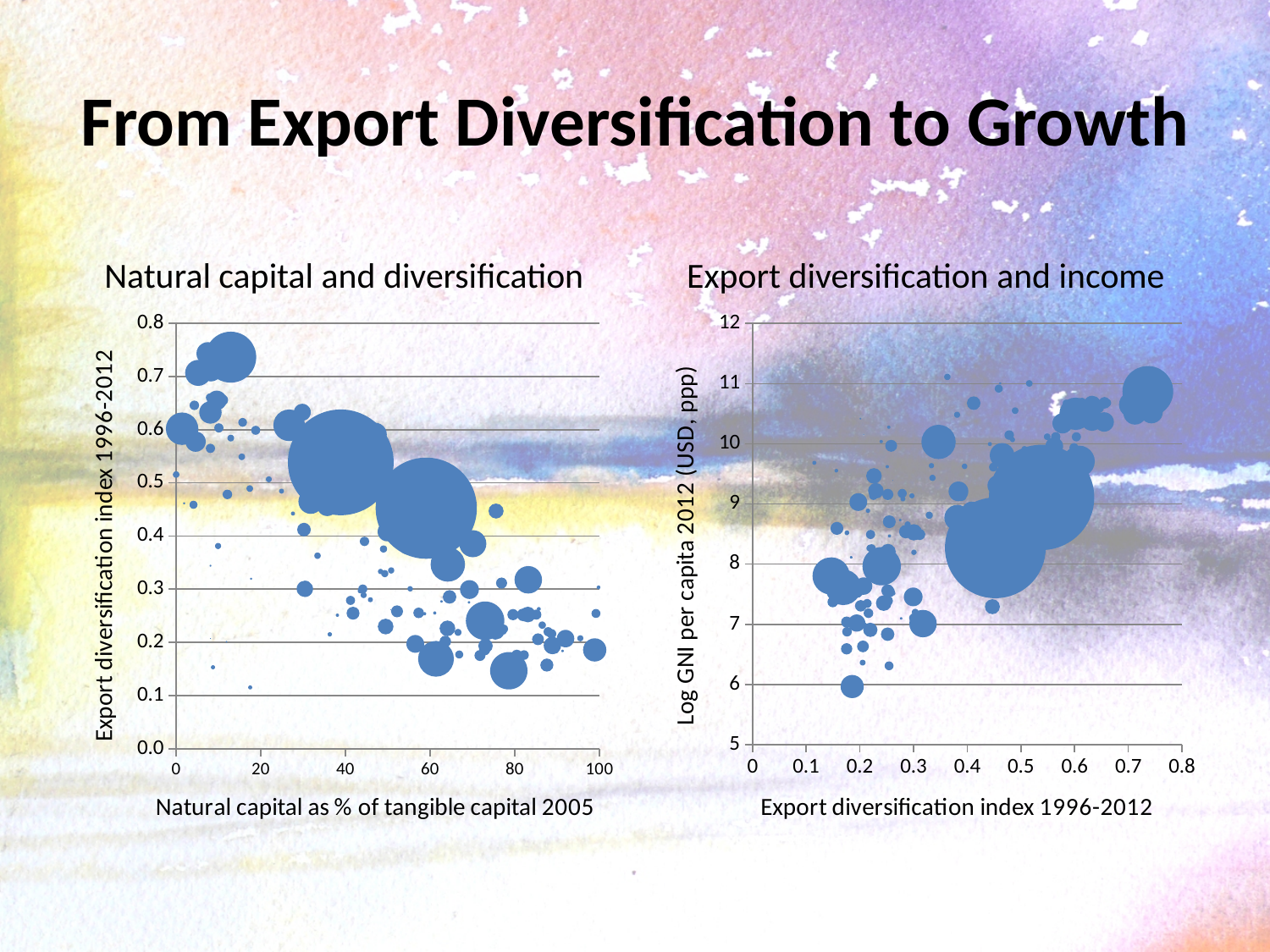
What is the y-axis label of the chart on the right of the slide? Log GNI per capita 2012 (USD, ppp) What kind of chart is the 'Export diversification and income' chart? bubble chart In the 'Export diversification and income' chart, does log GNI per capita generally rise or fall as the export diversification index increases? rise In the 'Natural capital and diversification' chart, do the export diversification index values generally rise or fall as natural capital as % of tangible capital increases? fall What kind of chart is the 'Natural capital and diversification' chart? bubble chart What is the title of the chart on the left of the slide? Natural capital and diversification